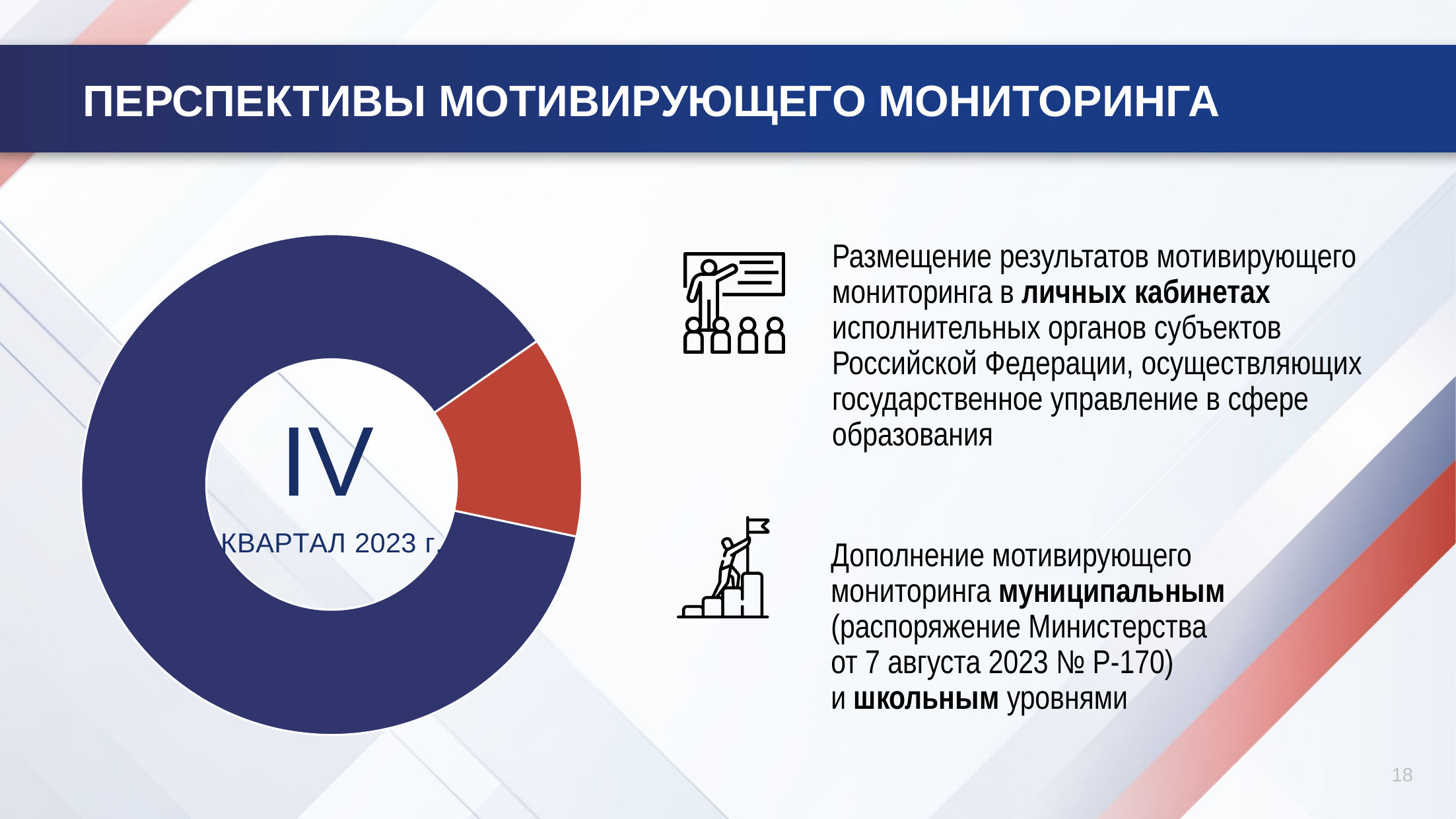
Does the donut chart on the slide have a legend? No Does the red slice cover more or less than half of the donut chart? less What kind of chart is shown on the left of the slide? donut (pie) chart How many slices does the donut chart on the slide have? 2 Which colour slice takes up the smallest part of the donut chart? red Which colour slice takes up the largest part of the donut chart? dark blue What text is written in the centre of the donut chart? IV КВАРТАЛ 2023 г. Which slice of the donut chart is larger, the dark blue one or the red one? dark blue